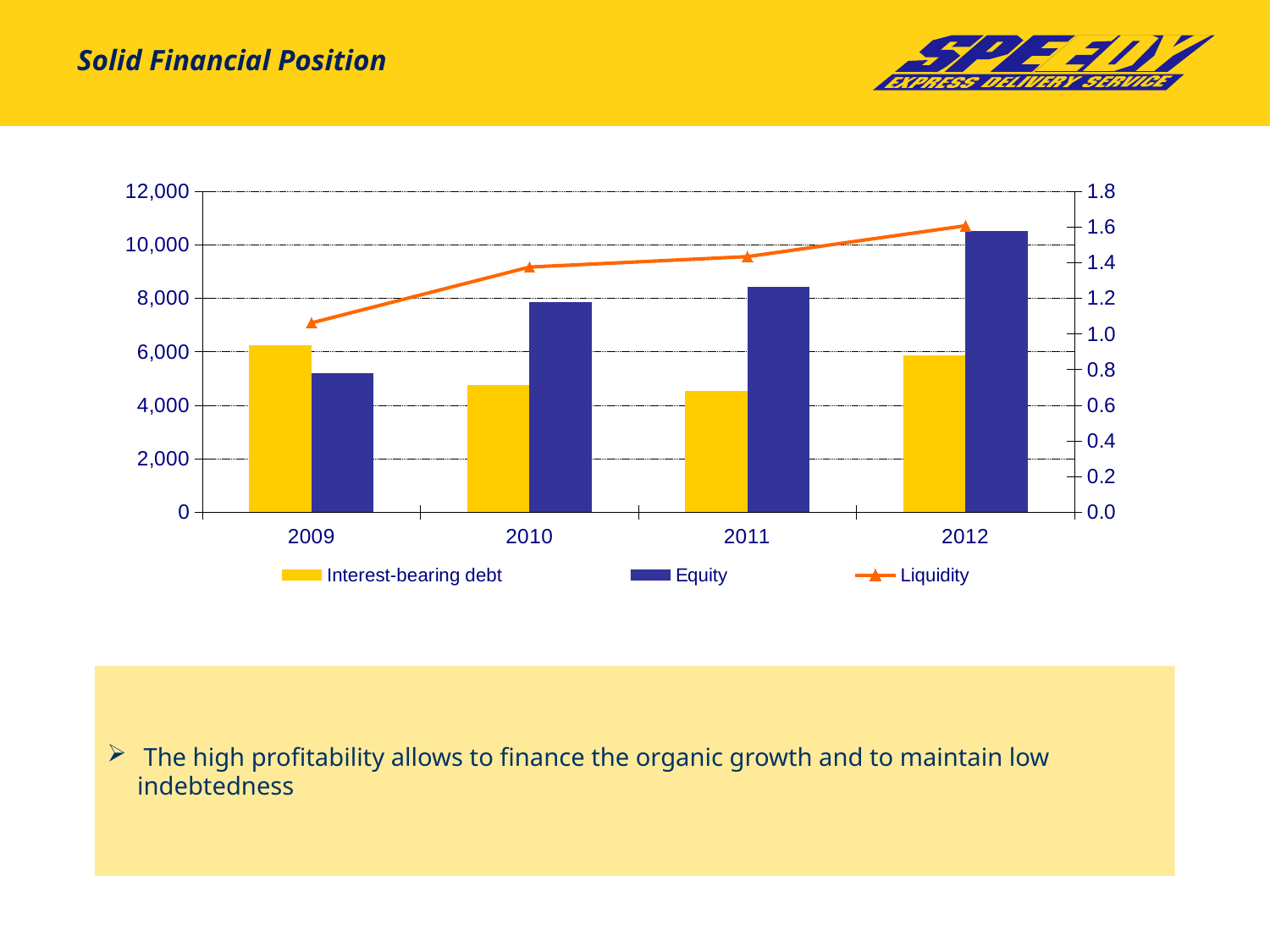
Which series is plotted as a line rather than bars? Liquidity In which year is Equity lowest? 2009 Is the value for Equity in 2012 greater or less than 10,000? greater What kind of chart is this? Combined bar and line chart How many years are shown on the x axis? 4 In 2009, which is larger: Interest-bearing debt or Equity? Interest-bearing debt In which year is Interest-bearing debt highest? 2009 How many series does the legend list? 3 In which year is Equity highest? 2012 Does Liquidity rise or fall from 2009 to 2012? Rises Does Equity rise or fall from 2009 to 2012? Rises